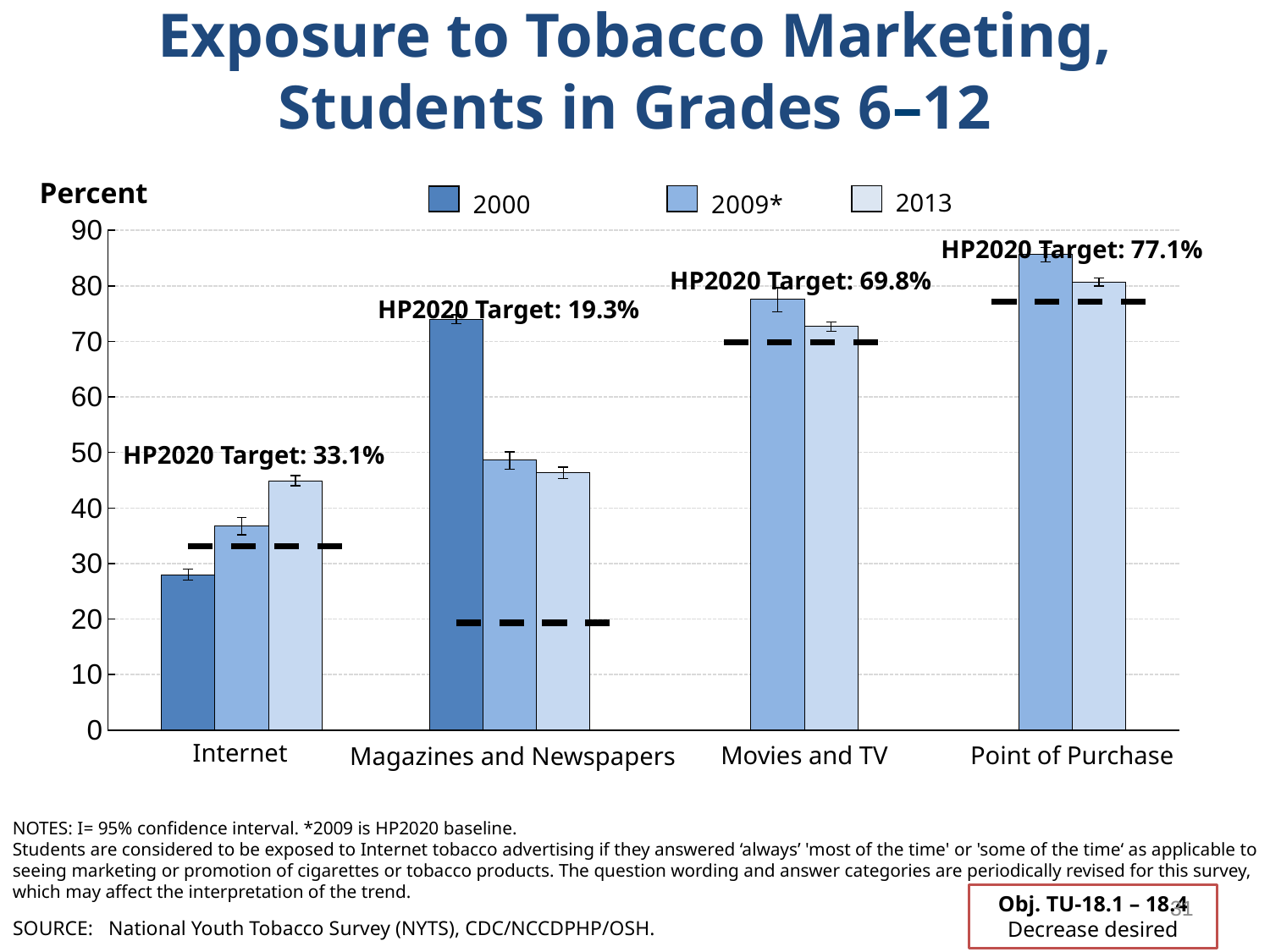
What is the HP2020 Target shown for Internet? 33.1% Which category has the highest 2013 value? Point of Purchase For Magazines and Newspapers, do the values rise or fall from 2000 to 2013? Fall What kind of chart is shown on the slide? Bar chart Is the 2000 value for Magazines and Newspapers greater or less than 70? greater How many marketing categories are shown on the x axis? 4 What is the HP2020 Target shown for Point of Purchase? 77.1% Which categories have no bar for the year 2000? Movies and TV and Point of Purchase Is the 2000 value for Internet greater or less than 30? less What is the difference between the HP2020 Target for Point of Purchase and the HP2020 Target for Movies and TV? 7.3 percentage points Which category has the lowest 2013 value? Internet How many series does the legend list? 3